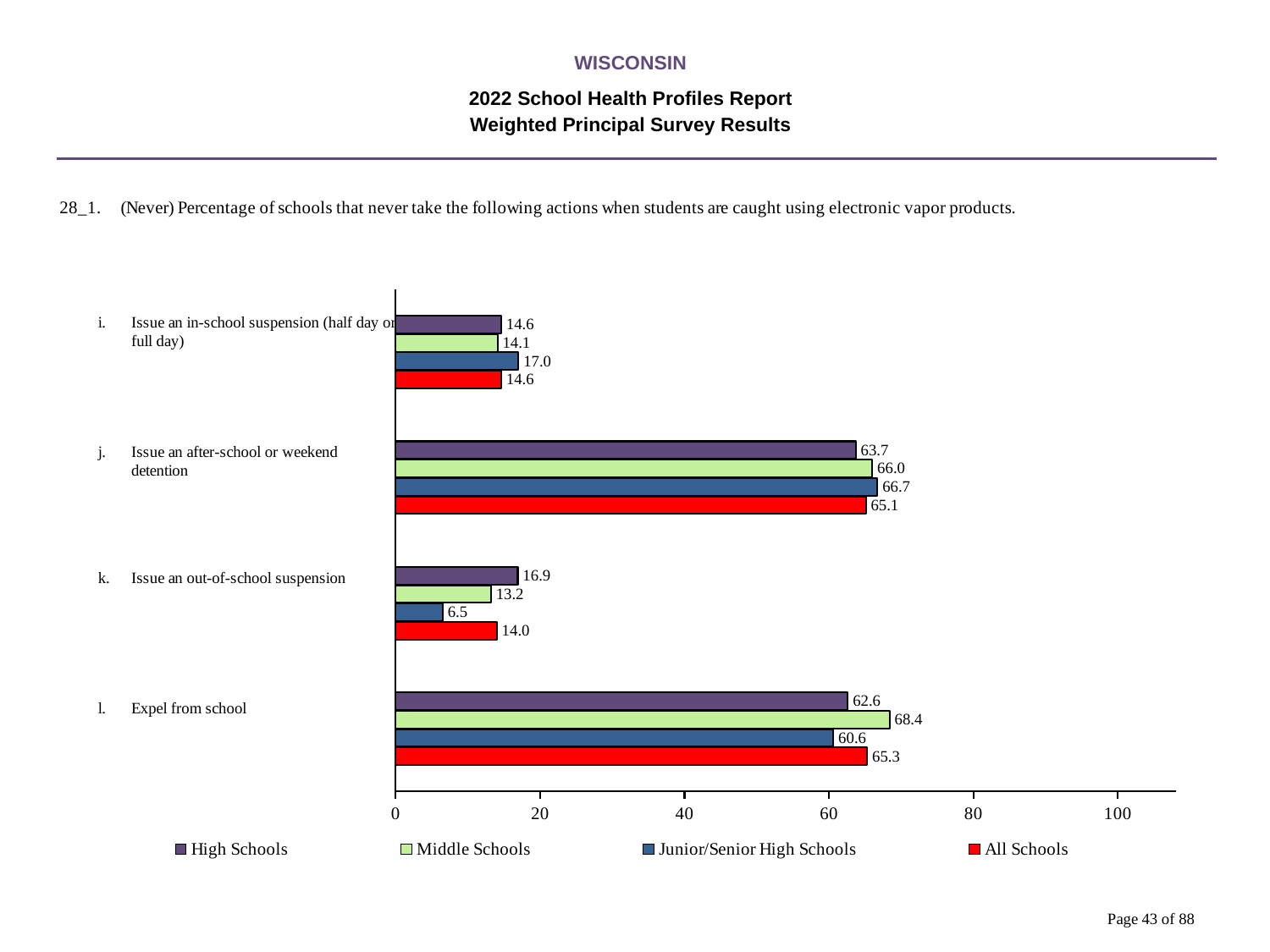
Which is larger for 'Issue an out-of-school suspension': High Schools or Middle Schools? High Schools What is the value for All Schools for 'Issue an after-school or weekend detention'? 65.1 What is the value for High Schools for 'Issue an in-school suspension (half day or full day)'? 14.6 What is the value for Middle Schools for 'Expel from school'? 68.4 Which school type has the lowest value for 'Issue an out-of-school suspension'? Junior/Senior High Schools Is the value for Junior/Senior High Schools for 'Issue an after-school or weekend detention' greater or less than 60? greater Which school type has the highest value for 'Expel from school'? Middle Schools What is the value for Junior/Senior High Schools for 'Issue an out-of-school suspension'? 6.5 How many series does the legend list? 4 How many action categories are shown on the chart? 4 What kind of chart is shown on the slide? Bar chart What is the difference between the Middle Schools and Junior/Senior High Schools values for 'Expel from school'? 7.8